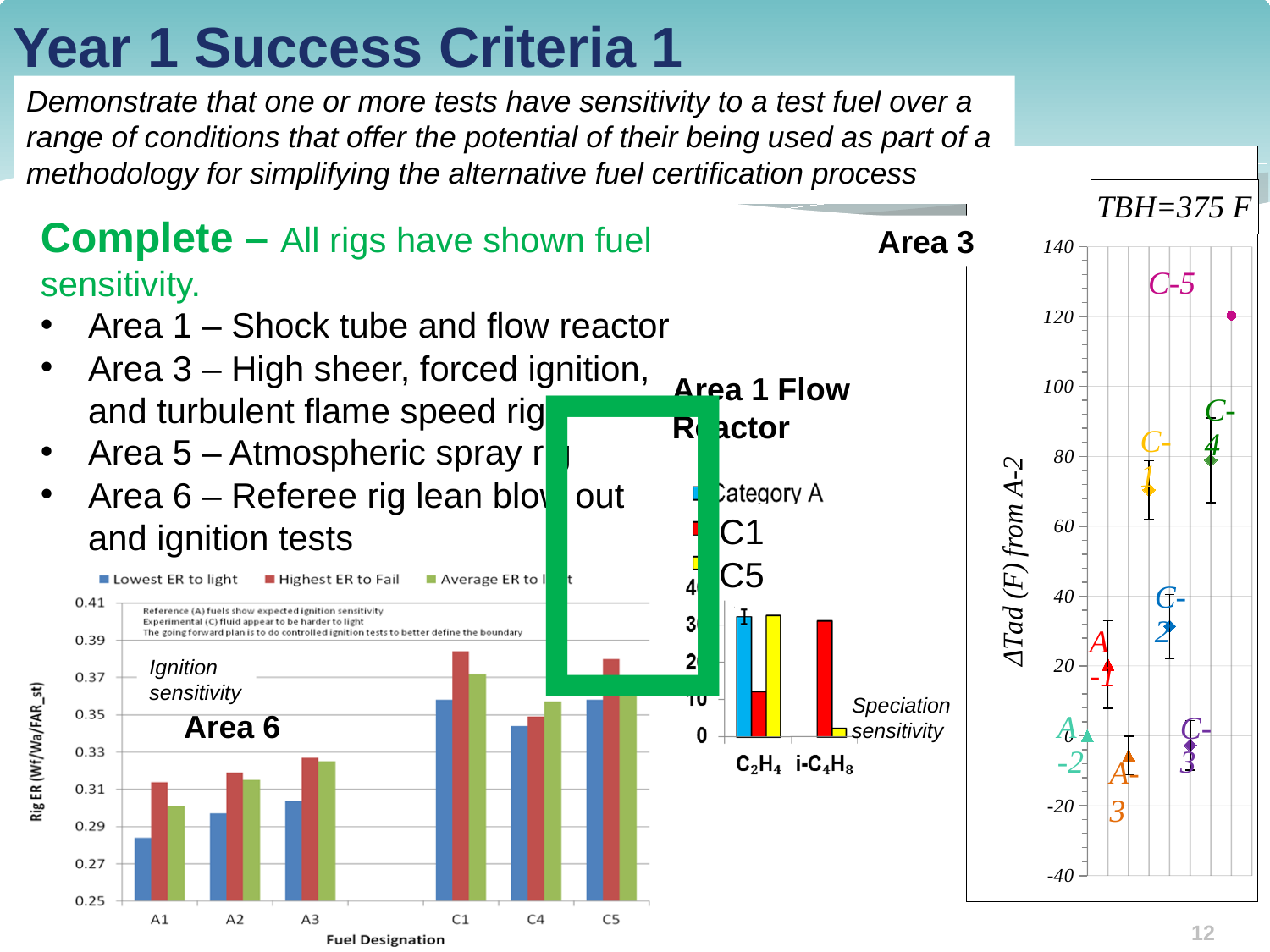
What is the y-axis label of the Area 3 chart on the right? ΔTad (F) from A-2 In the Area 6 chart, is the Lowest ER to light value for A1 greater or less than 0.31? less In the Area 3 chart on the right, is the value for C-5 greater or less than 100? greater How many series does the legend of the Area 1 Flow Reactor chart list? 3 What is the x-axis title of the Area 6 chart? Fuel Designation In the Area 3 chart on the right, which fuel has the highest ΔTad value? C-5 How many series does the legend of the Area 6 chart list? 3 How many fuel designations are shown on the x axis of the Area 6 chart? 6 In the Area 6 chart, which is larger, the Lowest ER to light value for A3 or for C1? C1 In the Area 6 chart, which fuel designation has the lowest Lowest ER to light value? A1 In the Area 6 chart, is the Highest ER to Fail value for C1 greater or less than 0.37? greater What kind of chart is the Area 6 chart at the bottom left of the slide? bar chart